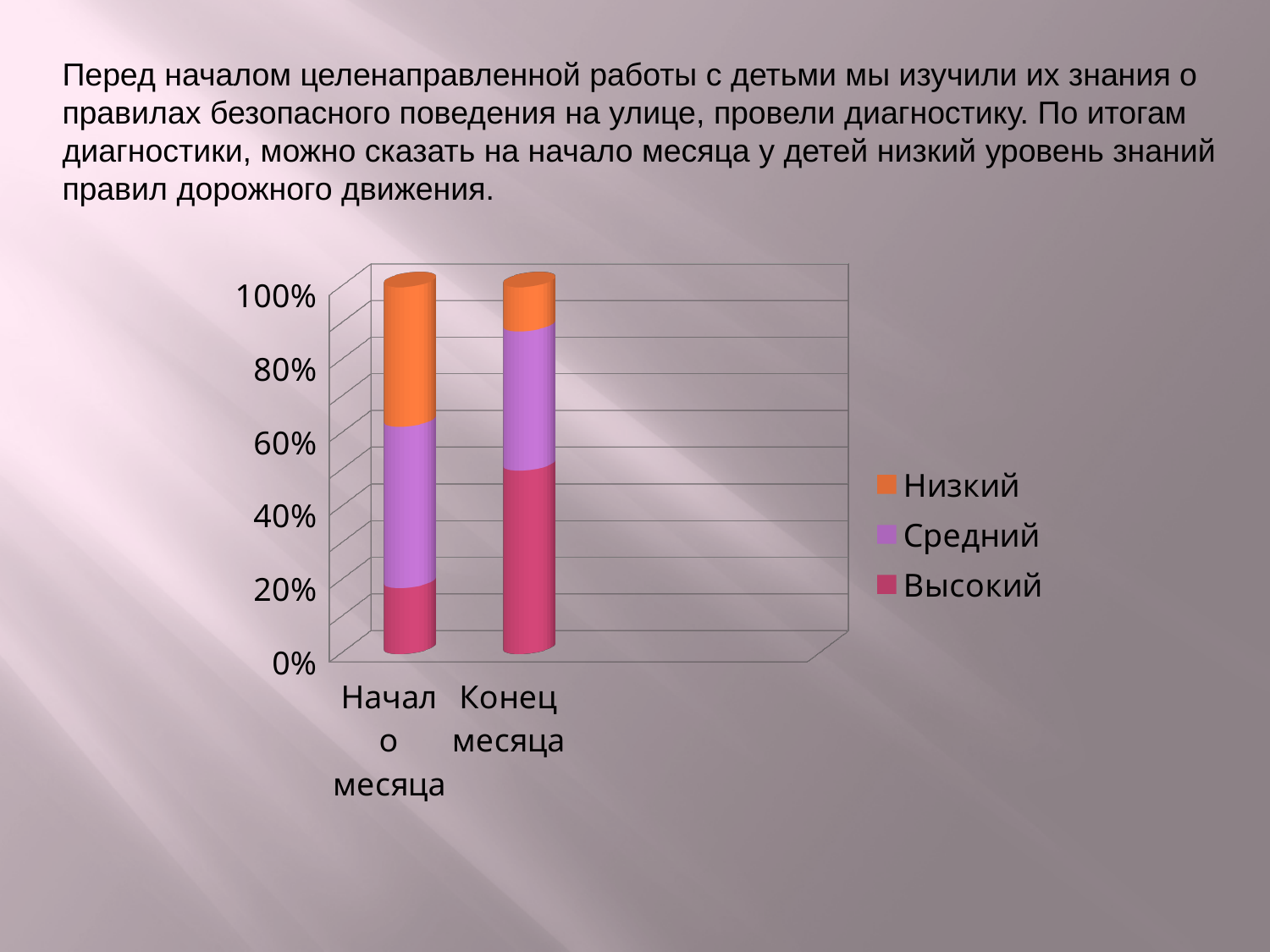
Which category has the larger Высокий share, Начало месяца or Конец месяца? Конец месяца How many series does the chart legend list? 3 Is the Низкий share for Начало месяца greater or less than 20%? greater Which category has the larger Низкий share, Начало месяца or Конец месяца? Начало месяца Which series is shown in purple in the chart legend? Средний Which series is shown in orange in the chart legend? Низкий Is the Низкий share for Конец месяца greater or less than 20%? less What kind of chart is shown on the slide? stacked bar chart How many categories are shown on the x axis of the chart? 2 Is the Высокий share for Начало месяца greater or less than 40%? less Does the Высокий share rise or fall from Начало месяца to Конец месяца? rise